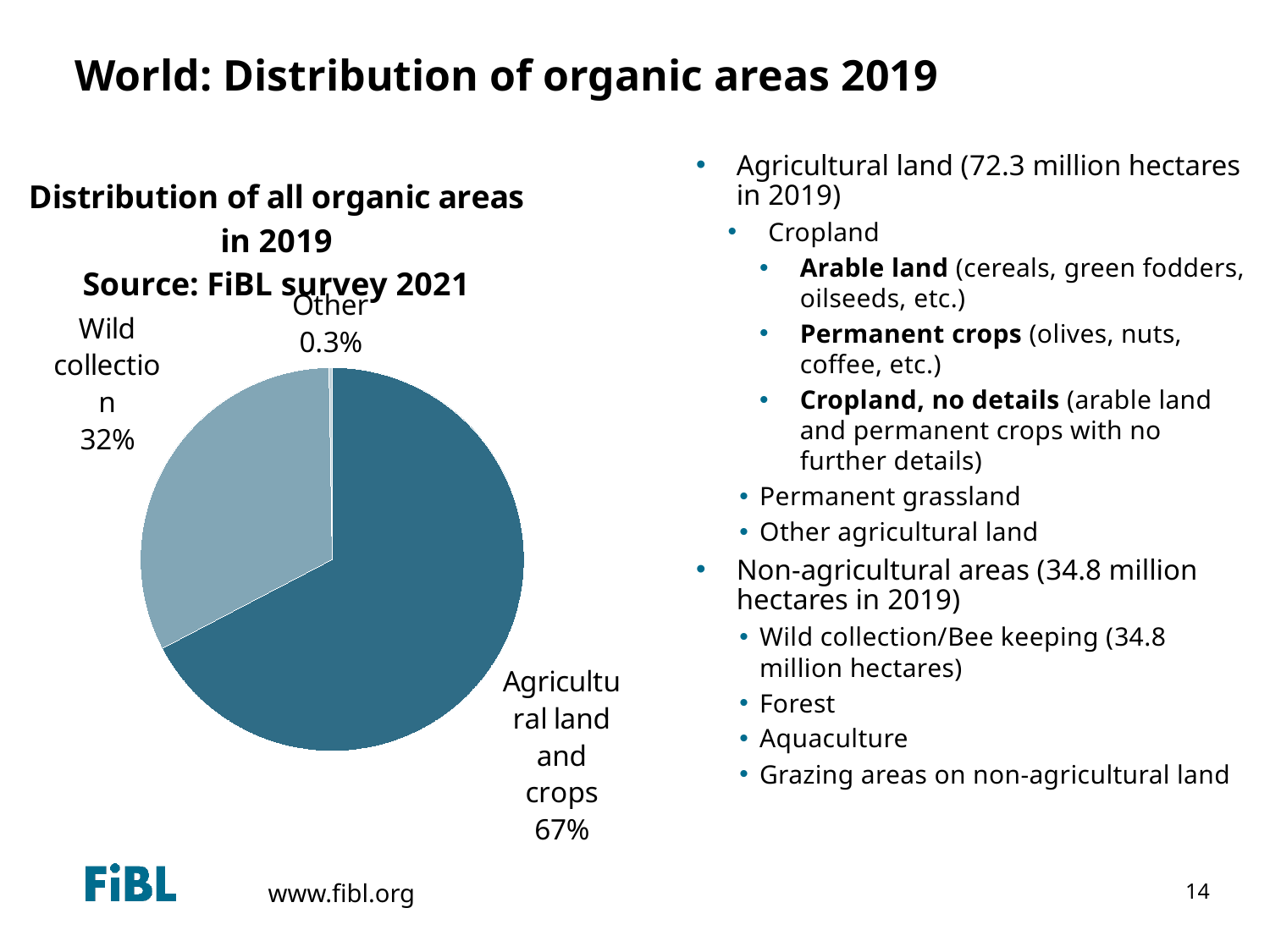
Which slice of the pie is the largest? Agricultural land and crops How many slices does the pie chart have? 3 What is the title of the pie chart? Distribution of all organic areas in 2019 Source: FiBL survey 2021 What share of the pie does Agricultural land and crops have? 67% Which is larger, the share for Wild collection or the share for Other? Wild collection What share of the pie does Wild collection have? 32% What is the difference in percentage points between the Agricultural land and crops share and the Wild collection share? 35 Which slice of the pie is the smallest? Other What kind of chart is shown on the slide? pie chart What share of the pie does Other have? 0.3% Which slice of the pie is shown in the lighter blue colour? Wild collection